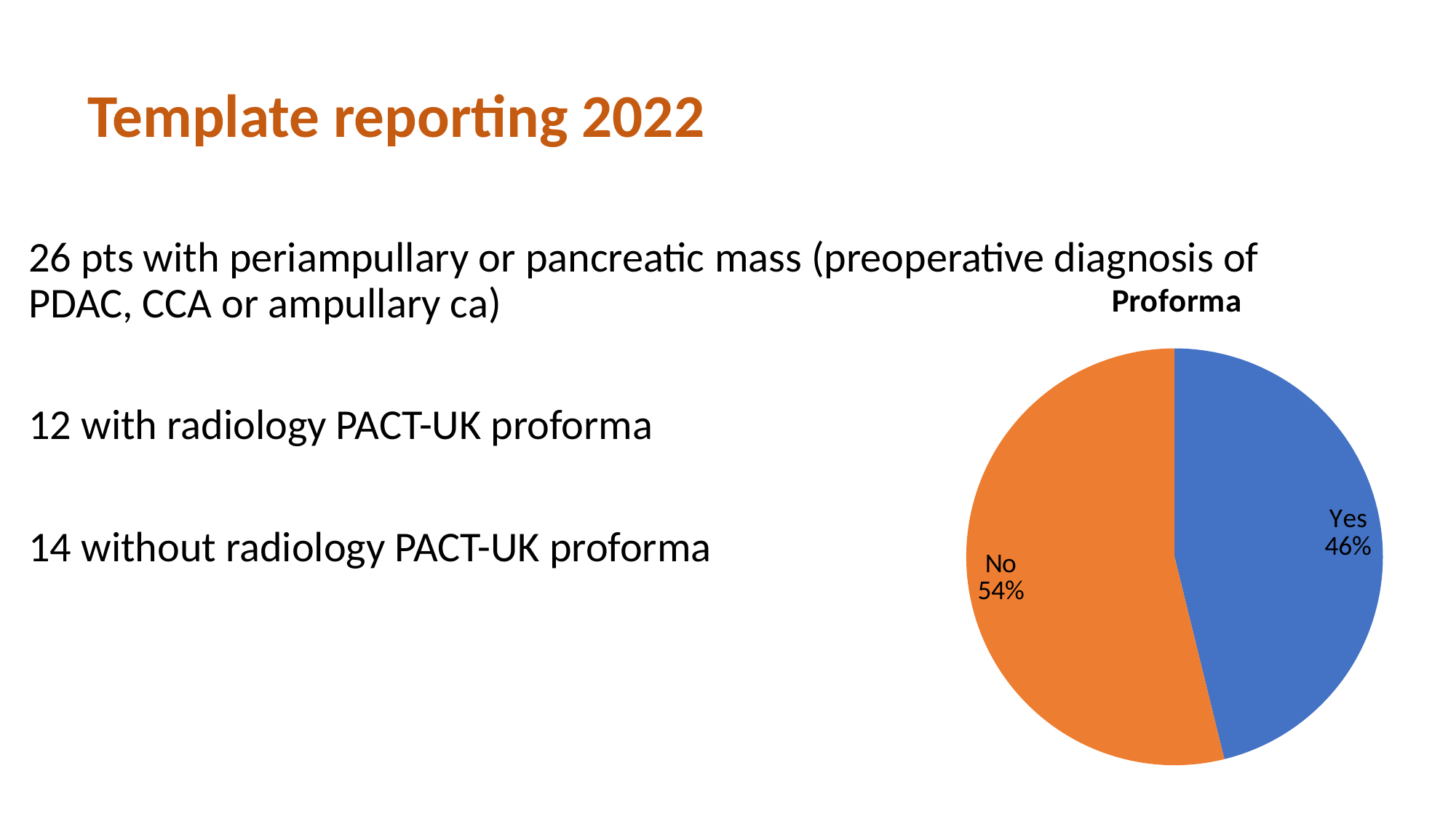
What share of the pie does the "Yes" slice represent? 46% What colour is the "No" slice of the pie? orange What is the difference in percentage points between the "No" slice and the "Yes" slice? 8 What type of chart is shown on the slide? pie chart What percentage of the pie is labelled "No"? 54% What percentage of the pie is labelled "Yes"? 46% Which slice of the pie is the smallest? Yes What is the title of the chart? Proforma How many slices does the pie chart have? 2 Which slice of the pie is the largest? No Which slice is larger, "Yes" or "No"? No